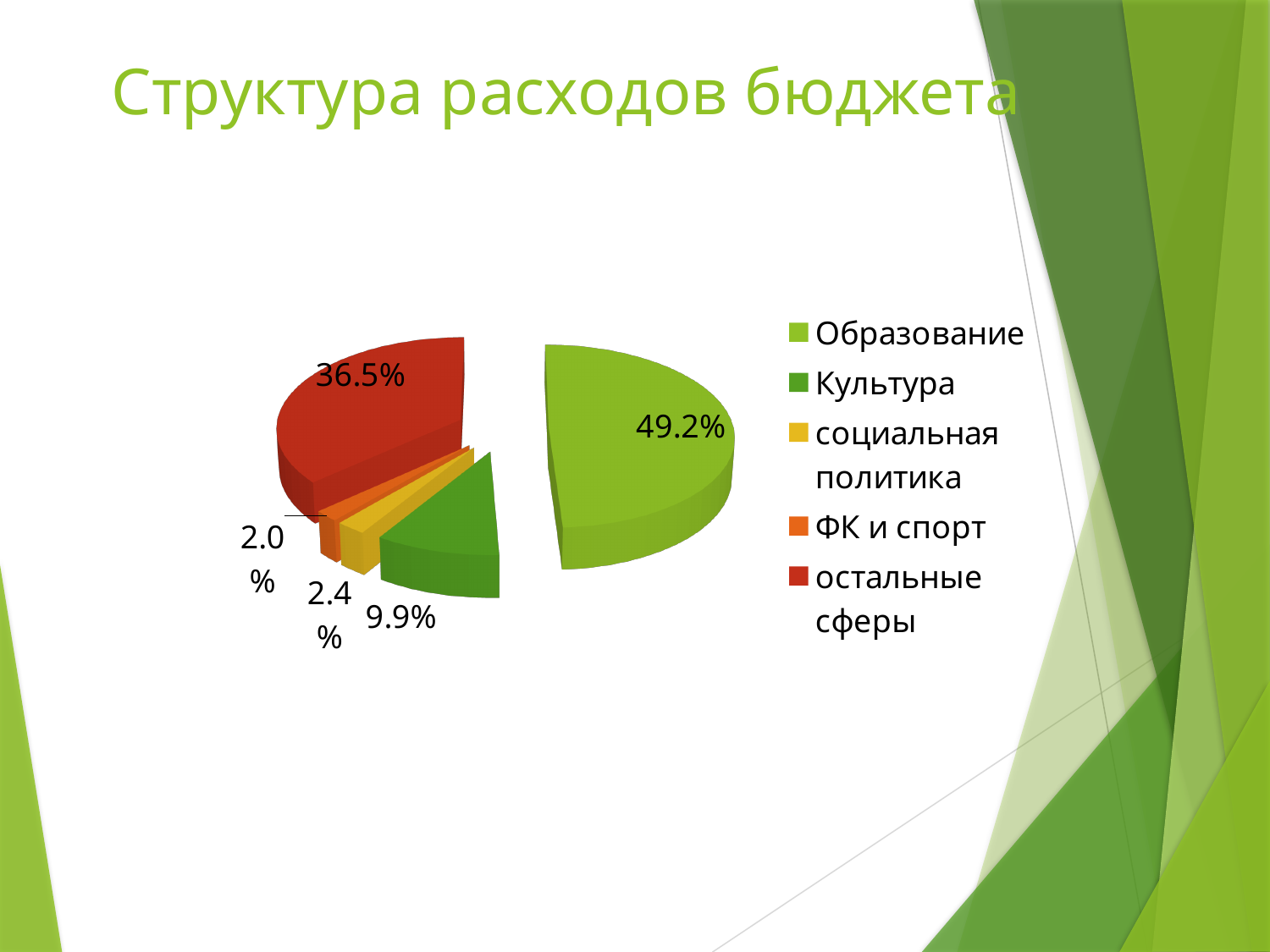
Which is larger, the share for Культура or the share for социальная политика? Культура What is the difference in percentage points between Образование and остальные сферы? 12.7 Which category has the smallest slice of the pie? ФК и спорт Which category has the largest slice of the pie? Образование What is the title of the chart on the slide? Структура расходов бюджета What share of the pie does остальные сферы have? 36.5% What share of the pie does Образование have? 49.2% What share of the pie does социальная политика have? 2.4% What kind of chart is shown on the slide? pie chart How many categories does the legend of the pie chart list? 5